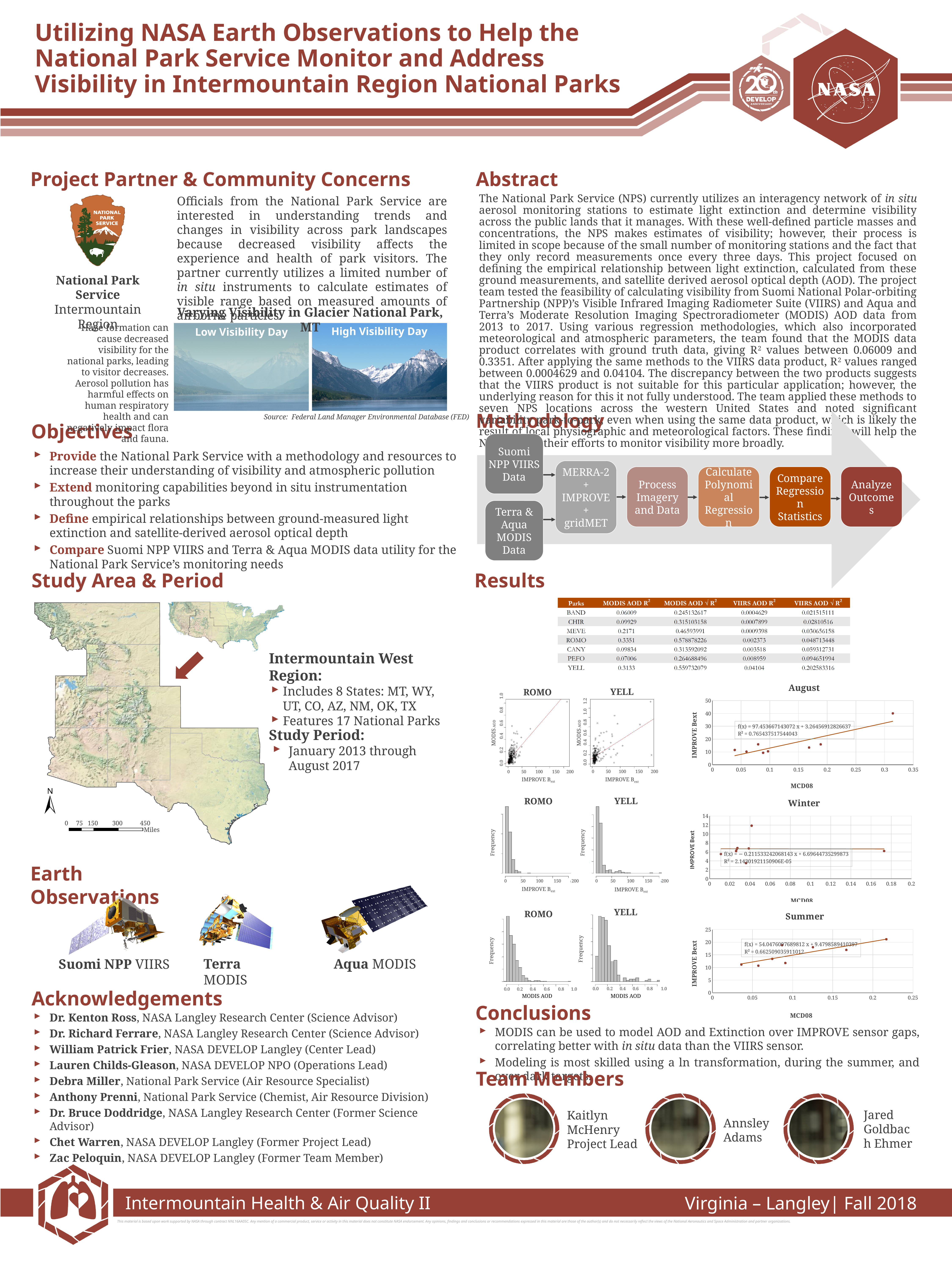
What kind of chart is the chart titled "August" in the Results section? scatter chart In the chart titled "Winter", is the highest IMPROVE Bext value greater or less than 10? greater In the chart titled "Winter", is the slope of the fitted trendline positive or negative? negative What R² value is printed on the chart titled "Winter"? 2.14201921150906E-05 In the chart titled "August", does the fitted trendline rise or fall as MCD08 increases? rise What R² value is printed on the chart titled "August"? 0.765437517544043 What is the highest tick value on the y axis of the chart titled "Winter"? 14 What kind of chart is the ROMO chart with "Frequency" on its y axis? bar chart What R² value is printed on the chart titled "Summer"? 0.662509035911012 Among the August, Winter and Summer charts, which one shows the highest R² value? August What is the label on the x axis of the chart titled "Summer"? MCD08 In the chart titled "August", is the highest IMPROVE Bext value greater or less than 30? greater